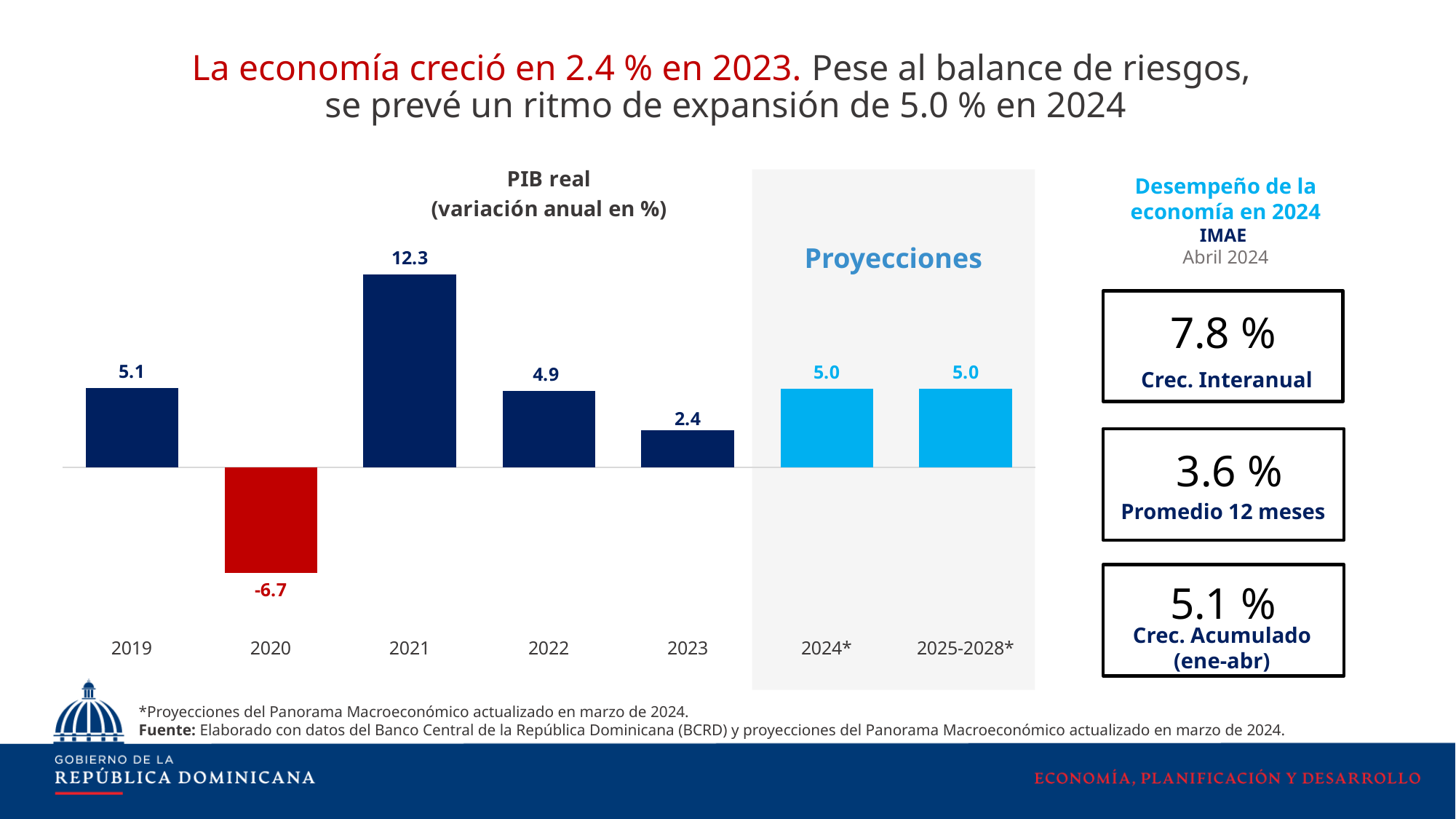
What colour is the bar for 2020 in the PIB real chart? red What kind of chart is the PIB real chart? bar chart Do the values in the PIB real chart rise or fall from 2021 to 2023? fall Which year has the highest value in the PIB real chart? 2021 What is the value for 2021 in the PIB real chart? 12.3 What is the difference between the 2021 and 2022 values in the PIB real chart? 7.4 What is the projected value for 2024* in the PIB real chart? 5.0 What is the value for 2020 in the PIB real chart? -6.7 What is the value for 2023 in the PIB real chart? 2.4 Which is larger in the PIB real chart, the value for 2019 or the value for 2022? 2019 Which year has the lowest value in the PIB real chart? 2020 How many categories are shown on the x axis of the PIB real chart? 7